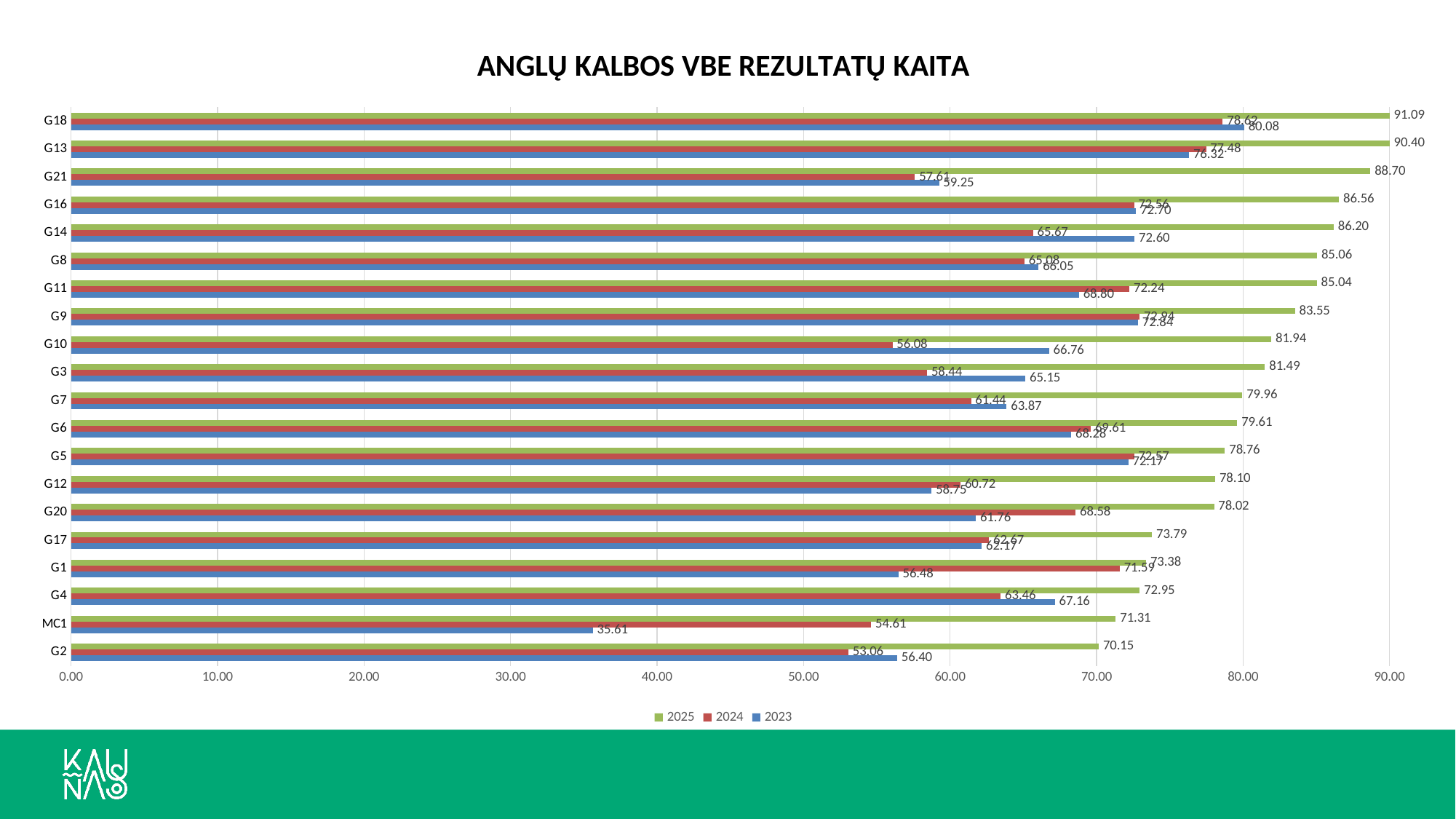
For G20, which is larger: the 2024 value or the 2023 value? 2024 Which category has the lowest 2023 value? MC1 What is the 2023 value for MC1? 35.61 What is the difference between the 2025 and 2023 values for MC1? 35.70 Which category has the highest 2025 value? G18 What is the 2025 value for G18? 91.09 How many series does the legend list? 3 What is the title of the chart? ANGLŲ KALBOS VBE REZULTATŲ KAITA Which category has the lowest 2025 value? G2 What is the 2024 value for G20? 68.58 What kind of chart is shown on the slide? bar chart How many categories (schools) are shown on the chart? 20